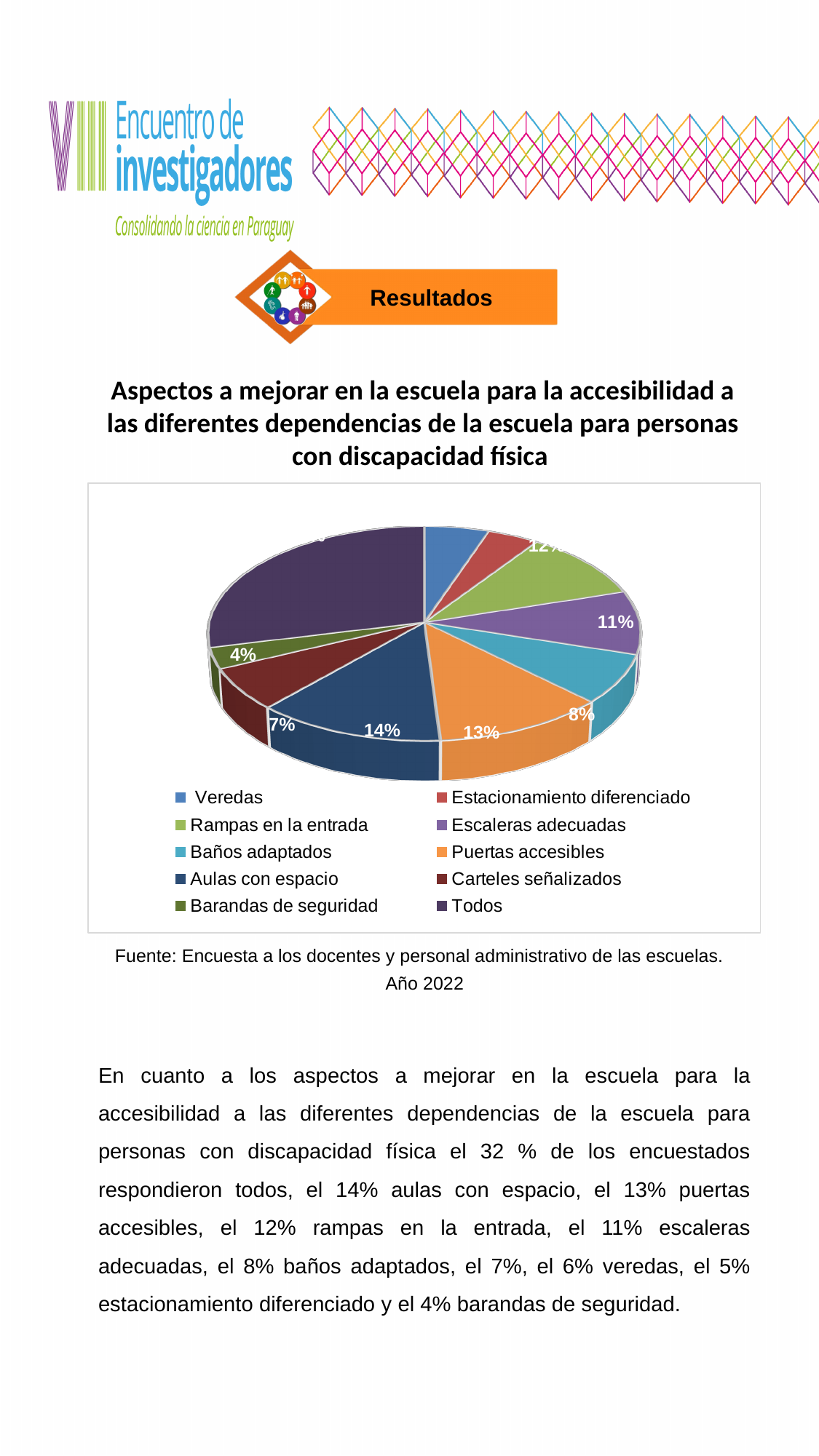
What percentage is shown for Escaleras adecuadas? 11% What percentage is shown for Barandas de seguridad? 4% What kind of chart is shown on the slide? Pie chart What percentage is shown for Baños adaptados? 8% What percentage is shown for Aulas con espacio? 14% What percentage is shown for Carteles señalizados? 7% What percentage is shown for Puertas accesibles? 13% Which is larger, the share for Aulas con espacio or the share for Puertas accesibles? Aulas con espacio How many categories does the pie chart's legend list? 10 What is the difference in percentage points between Aulas con espacio and Barandas de seguridad? 10 percentage points Which category has the largest slice of the pie? Todos Which category is shown in orange in the pie chart? Puertas accesibles